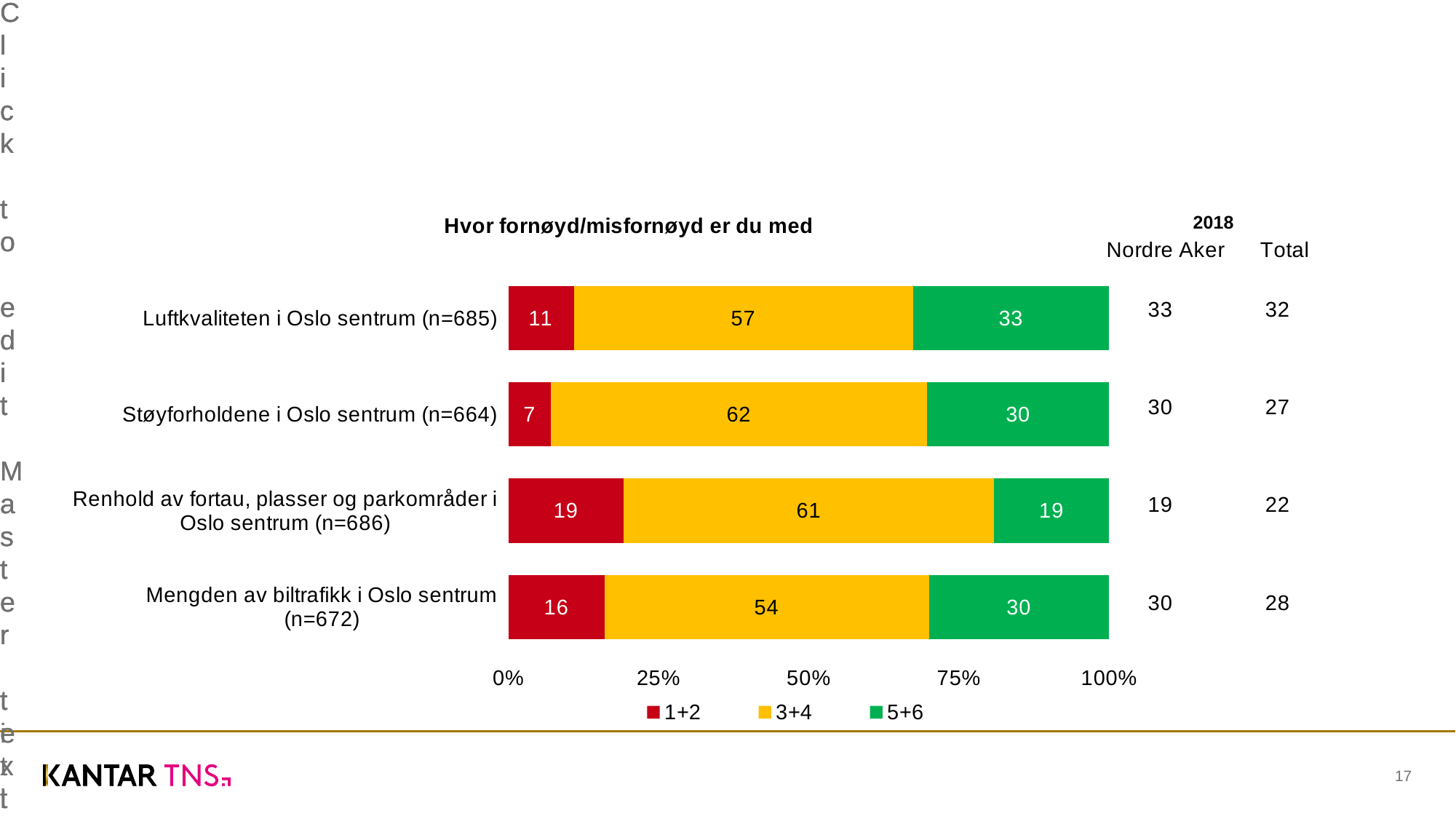
How many series does the legend list? 3 Which colour represents the 5+6 series in the chart? Green What is the difference between the 3+4 values for "Støyforholdene i Oslo sentrum (n=664)" and "Mengden av biltrafikk i Oslo sentrum (n=672)"? 8 Which is larger: the 5+6 value for "Luftkvaliteten i Oslo sentrum (n=685)" or the 5+6 value for "Renhold av fortau, plasser og parkområder i Oslo sentrum (n=686)"? Luftkvaliteten i Oslo sentrum (n=685) What is the value of the 5+6 segment for "Luftkvaliteten i Oslo sentrum (n=685)"? 33 How many categories are plotted in the chart? 4 What kind of chart is shown on the slide? Stacked bar chart Which category has the lowest 1+2 value? Støyforholdene i Oslo sentrum (n=664) What is the value of the 1+2 segment for "Renhold av fortau, plasser og parkområder i Oslo sentrum (n=686)"? 19 What is the value of the 3+4 segment for "Støyforholdene i Oslo sentrum (n=664)"? 62 What is the title of the chart? Hvor fornøyd/misfornøyd er du med Which category has the highest 1+2 value? Renhold av fortau, plasser og parkområder i Oslo sentrum (n=686)